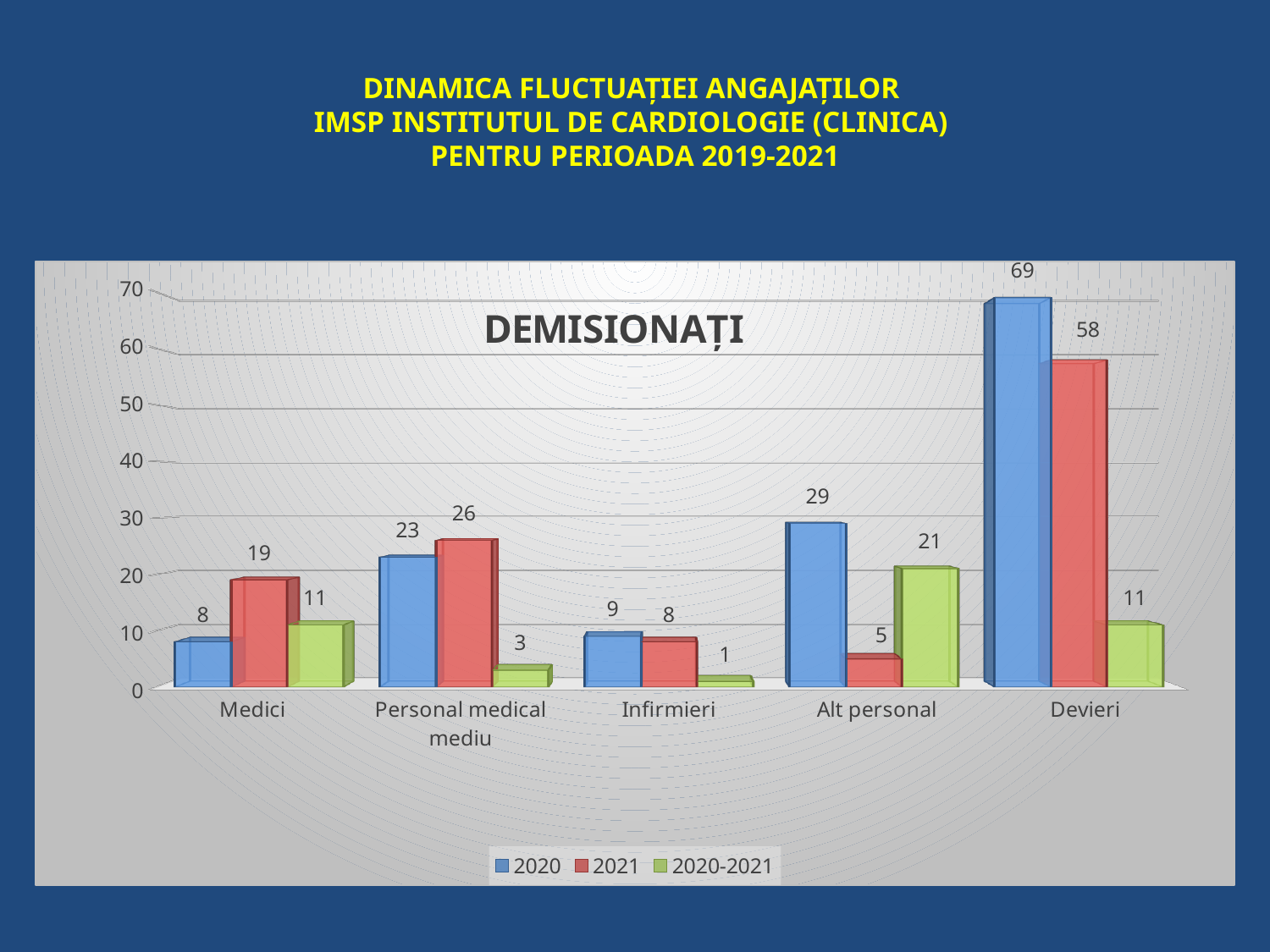
How many categories are shown on the x axis? 5 Which category has the lowest value in the 2021 series? Alt personal Which category has the highest value in the 2020 series? Devieri What is the difference between the 2020 and 2021 values for Devieri? 11 What kind of chart is shown on the slide? bar chart What is the value for Alt personal in the 2020 series? 29 Which is larger for Personal medical mediu: the 2020 value or the 2021 value? 2021 What is the value for Medici in the 2021 series? 19 What is the title shown inside the chart area? DEMISIONAȚI What colour represents the 2020-2021 series in the legend? green What is the value for Infirmieri in the 2020-2021 series? 1 How many series does the legend list? 3